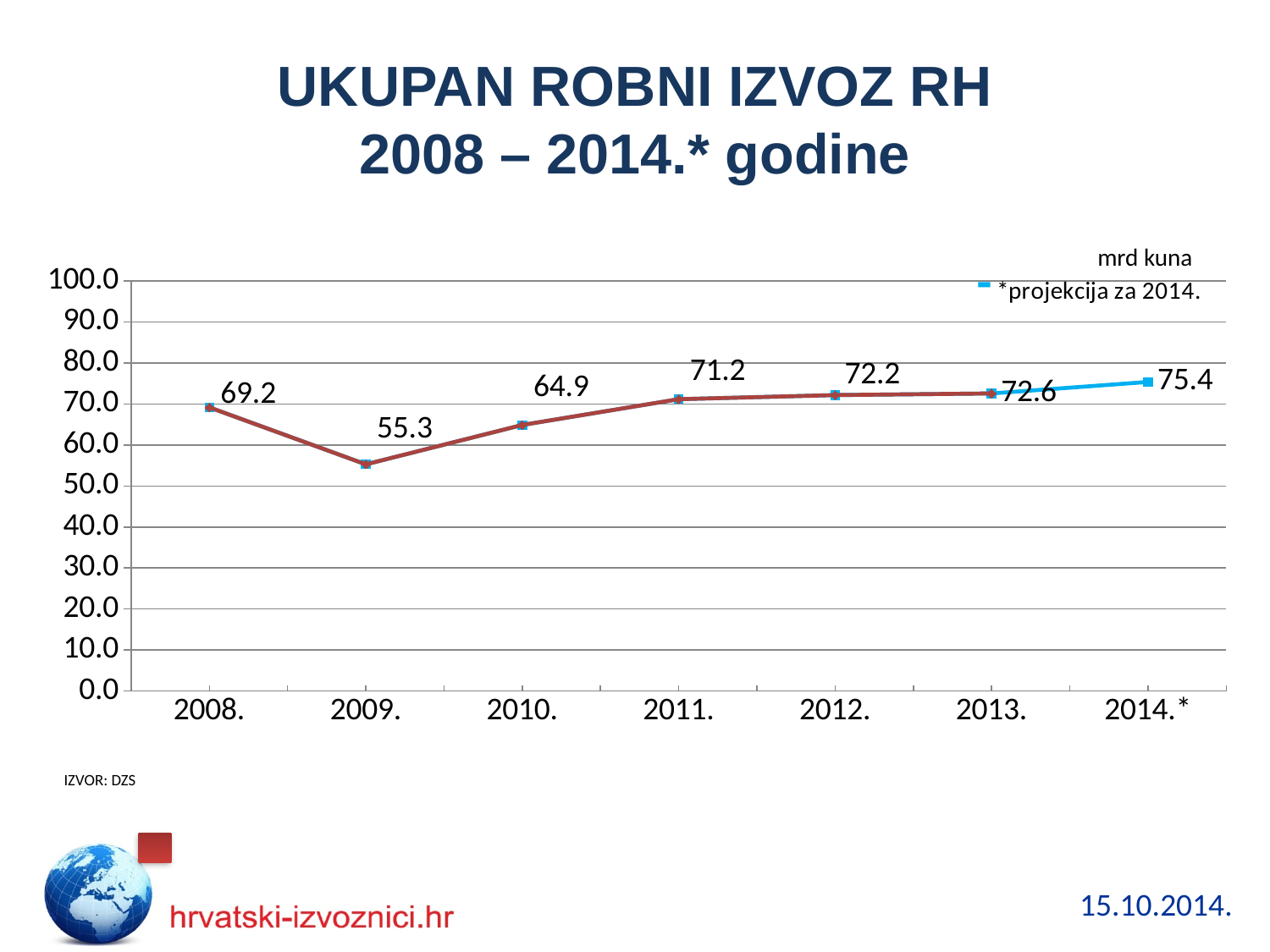
Is the value for 2013. greater or less than 70.0? greater What is the value for 2009.? 55.3 Which year has the lowest value? 2009. What is the difference between the values for 2008. and 2009.? 13.9 What kind of chart is shown on the slide? line chart What is the value for 2008.? 69.2 What unit is stated for the values in the chart? mrd kuna Which year has the highest value? 2014.* Which is larger, the value for 2010. or the value for 2012.? 2012. What is the value for 2011.? 71.2 What is the projected value for 2014.*? 75.4 How many years are plotted on the x axis? 7